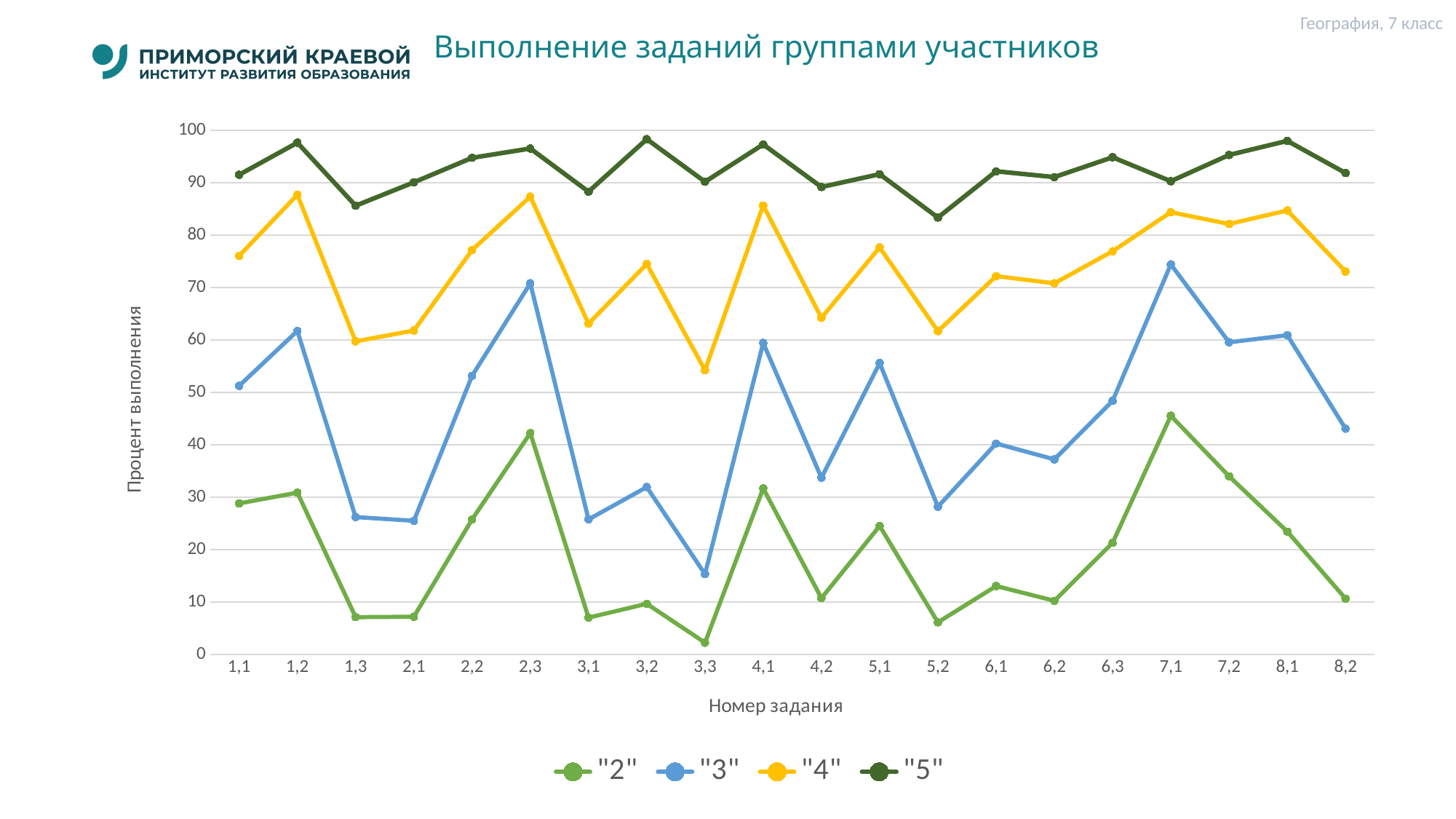
For which task number is the value of series "2" the highest? 7,1 Is the value for series "5" at task 5,2 greater or less than 90? less For series "3", which task has the larger value: 1,2 or 1,3? 1,2 For which task number is the value of series "4" the lowest? 3,3 Is the value for series "3" at task 7,1 greater or less than 70? greater What is the label of the y axis? Процент выполнения How many task numbers are shown along the x axis? 20 Is the value for series "4" at task 3,3 greater or less than 60? less For which task number is the value of series "2" the lowest? 3,3 For which task number is the value of series "3" the lowest? 3,3 What kind of chart is shown on the slide? line chart How many series does the legend list? 4